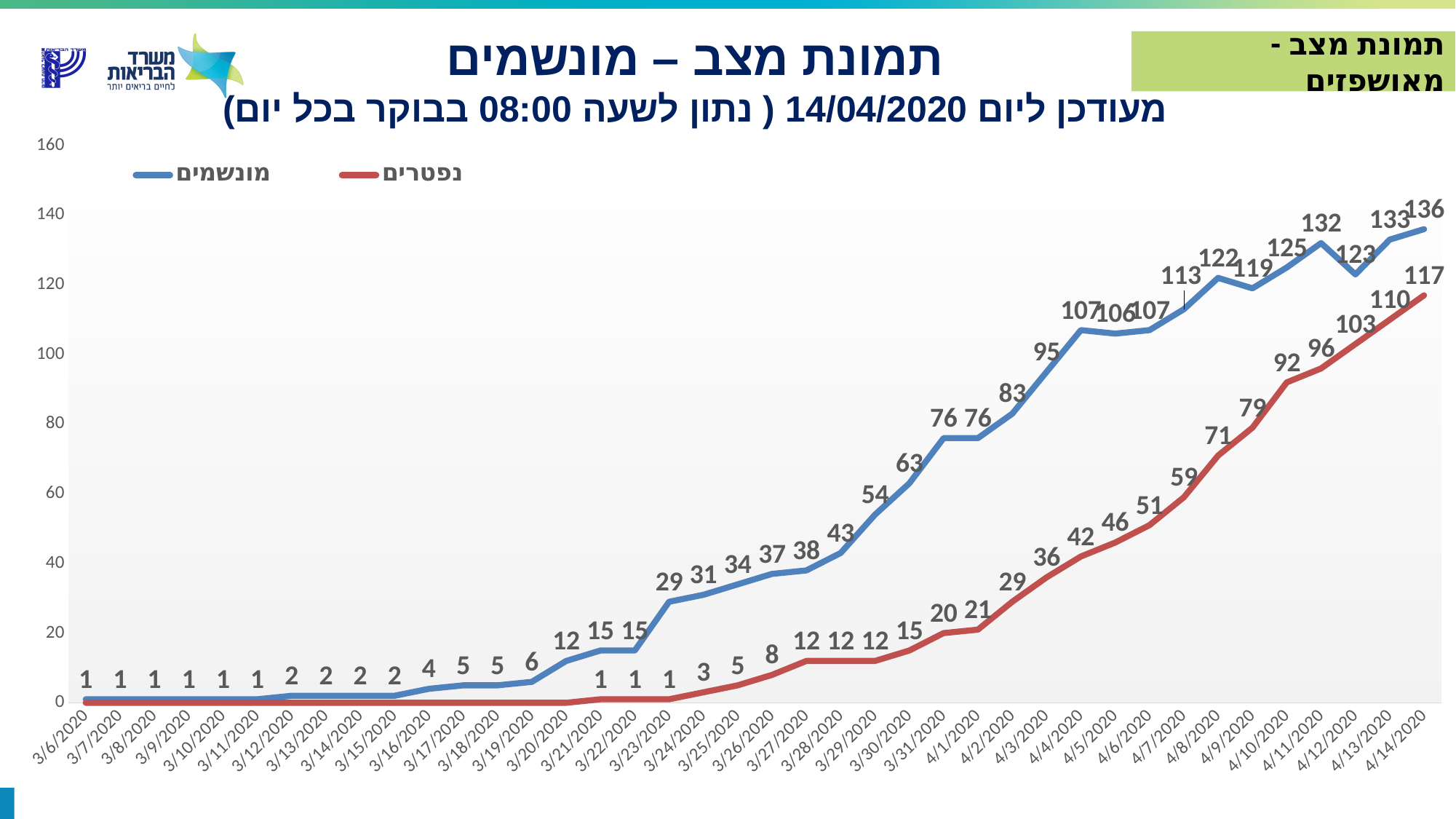
What is the value of the נפטרים series on 4/10/2020? 92 How many series does the legend list? 2 Which colour is used for the נפטרים series? red Does the נפטרים series generally rise or fall from 3/21/2020 to 4/14/2020? rise What is the value of the נפטרים series on 4/14/2020? 117 How many dates are shown on the x axis? 40 What is the difference between the מונשמים and נפטרים values on 4/14/2020? 19 What is the value of the מונשמים series on 4/14/2020? 136 On which date does the מונשמים series reach its highest value? 4/14/2020 What kind of chart is shown on the slide? line chart What is the value of the מונשמים series on 4/11/2020? 132 Which series has the larger value on 4/8/2020, מונשמים or נפטרים? מונשמים